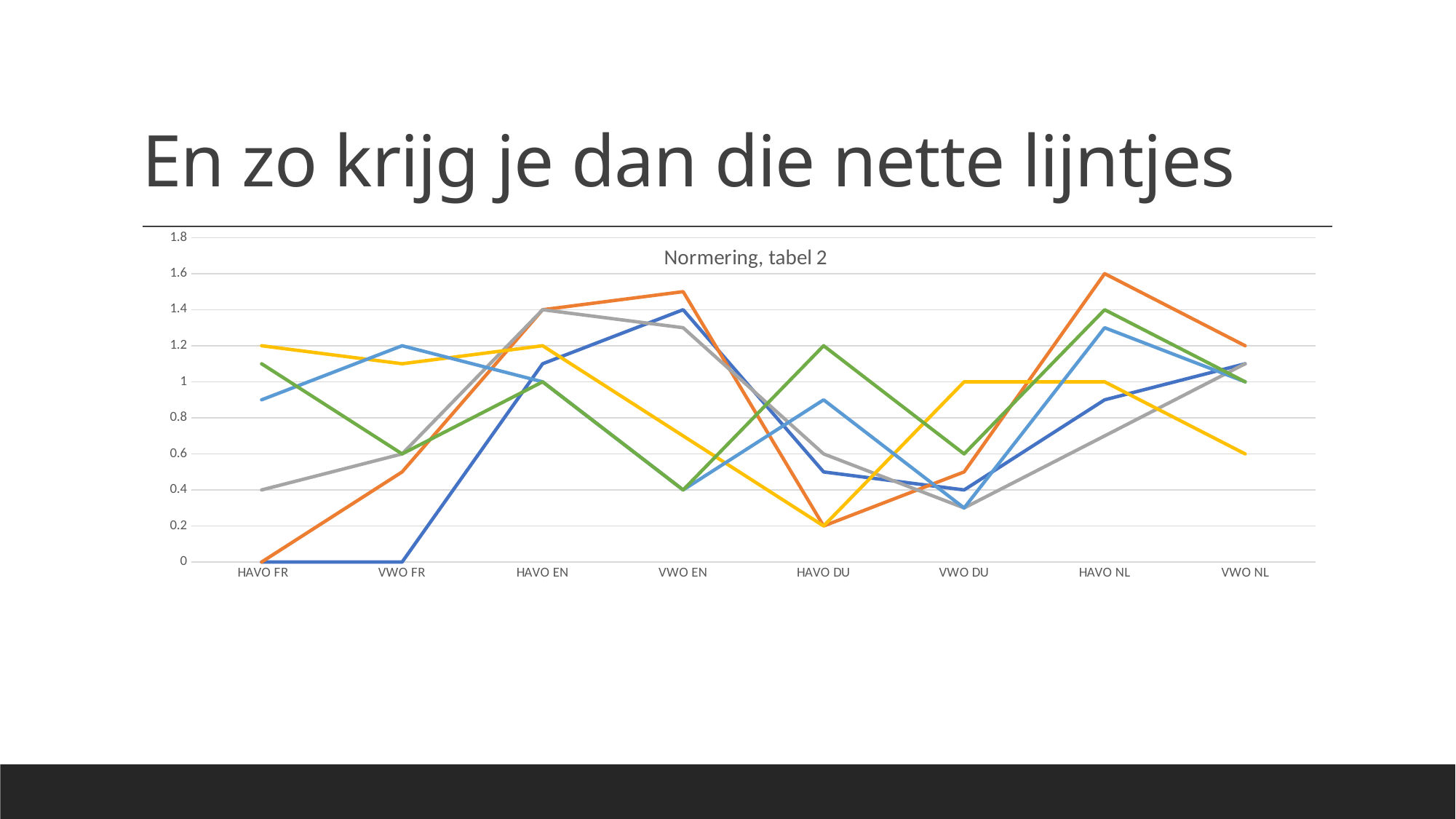
What is the value of the orange line at HAVO NL? 1.6 What is the title of the chart? Normering, tabel 2 What is the value of the dark blue line at VWO FR? 0 How many categories are shown on the x axis of the chart? 8 At which category does any line reach the highest value on the chart? HAVO NL Is the value of the orange line at VWO EN greater or less than 1.4? greater Is the value of the yellow line at VWO NL greater or less than 1? less What is the value of the yellow line at HAVO FR? 1.2 Does the chart display a legend naming its series? No What kind of chart is shown on the slide? line chart At HAVO DU, which line has the larger value, the green line or the orange line? green line What is the value of the orange line at HAVO FR? 0